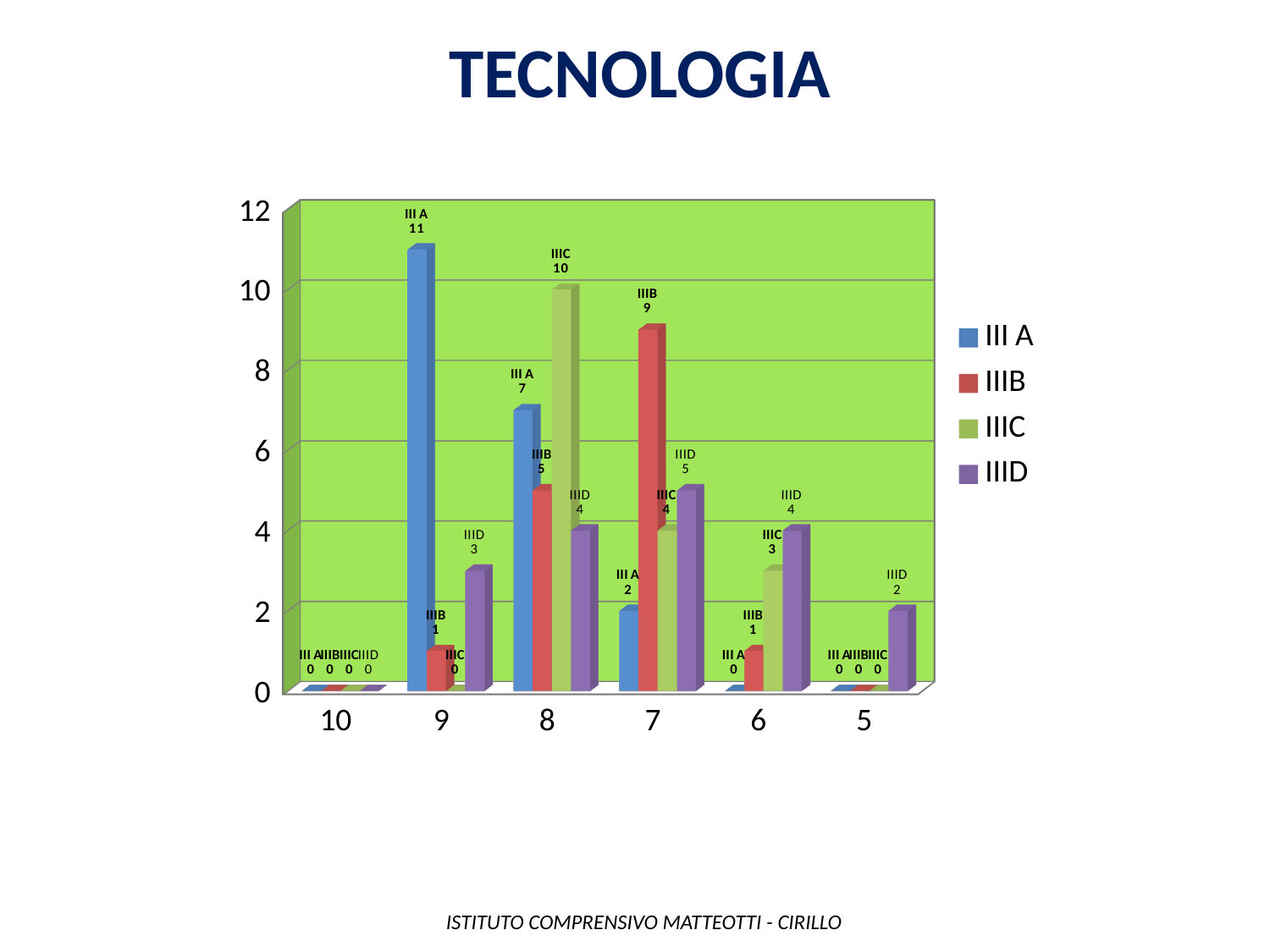
What is the value for III A at category 9? 11 What is the value for IIIB at category 7? 9 What is the difference between the III A value and the IIIB value at category 9? 10 Which series has the lowest value at category 7? III A How many categories are shown on the x axis? 6 What is the value for IIIC at category 8? 10 What is the value for IIID at category 5? 2 What is the title of the chart? TECNOLOGIA Which is larger at category 6: the IIIC value or the IIID value? IIID What kind of chart is shown on the slide? bar chart How many series does the legend list? 4 Which series has the highest value at category 8? IIIC